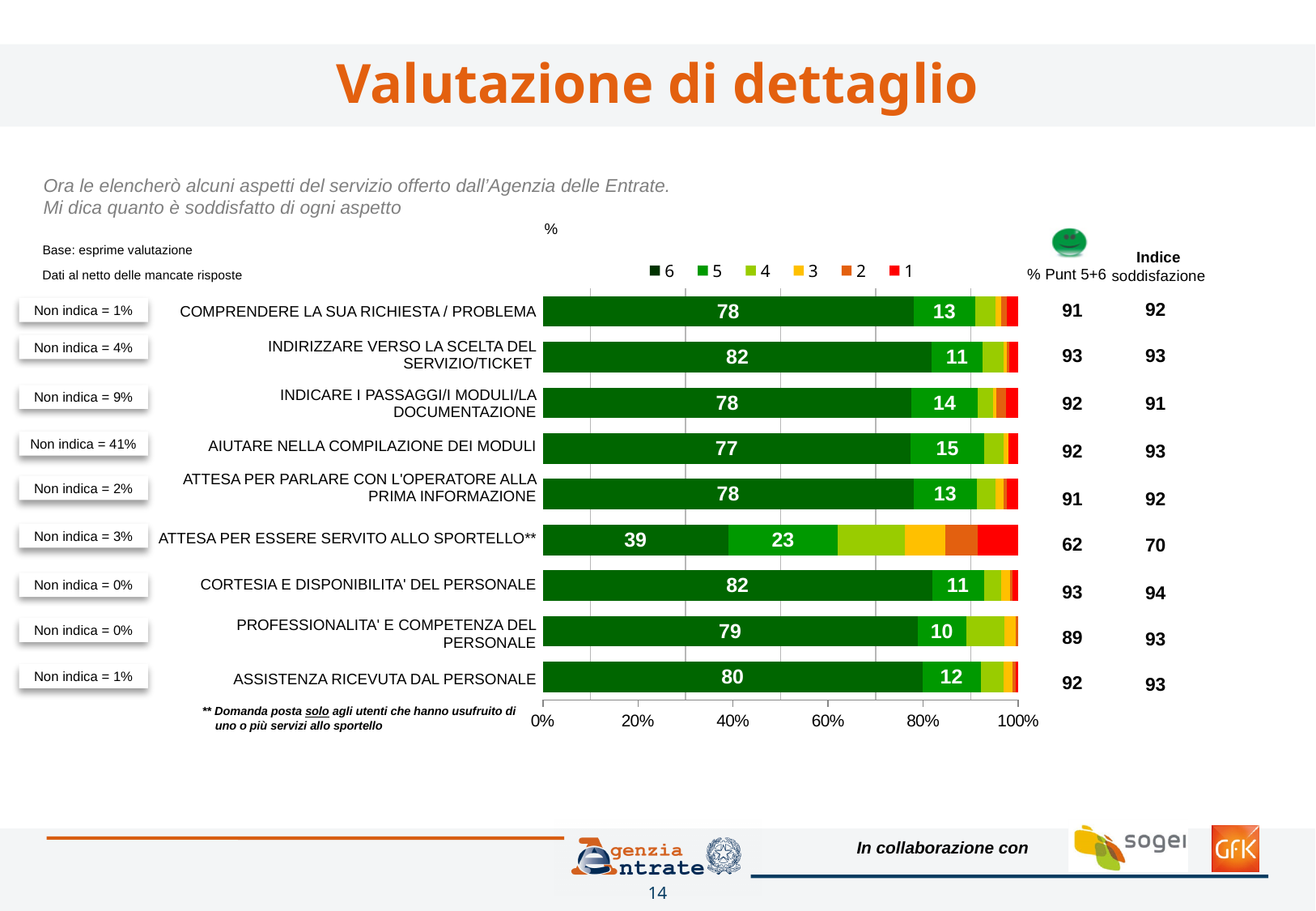
Which category has the highest value for the "5" series? ATTESA PER ESSERE SERVITO ALLO SPORTELLO** Which has a larger "6" value: PROFESSIONALITA' E COMPETENZA DEL PERSONALE or ASSISTENZA RICEVUTA DAL PERSONALE? ASSISTENZA RICEVUTA DAL PERSONALE What is the value of the "6" series for COMPRENDERE LA SUA RICHIESTA / PROBLEMA? 78 How many categories are shown in the chart? 9 Is the "6" value for ATTESA PER ESSERE SERVITO ALLO SPORTELLO** greater or less than 60%? less What is the value of the "5" series for ATTESA PER ESSERE SERVITO ALLO SPORTELLO**? 23 Which category has the lowest value for the "6" series? ATTESA PER ESSERE SERVITO ALLO SPORTELLO** What is the combined value of the "6" and "5" series for CORTESIA E DISPONIBILITA' DEL PERSONALE? 93 What kind of chart is shown on the slide? Stacked bar chart What is the value of the "5" series for PROFESSIONALITA' E COMPETENZA DEL PERSONALE? 10 How many series does the legend list? 6 What is the difference between the "6" value for INDIRIZZARE VERSO LA SCELTA DEL SERVIZIO/TICKET and the "6" value for ATTESA PER ESSERE SERVITO ALLO SPORTELLO**? 43